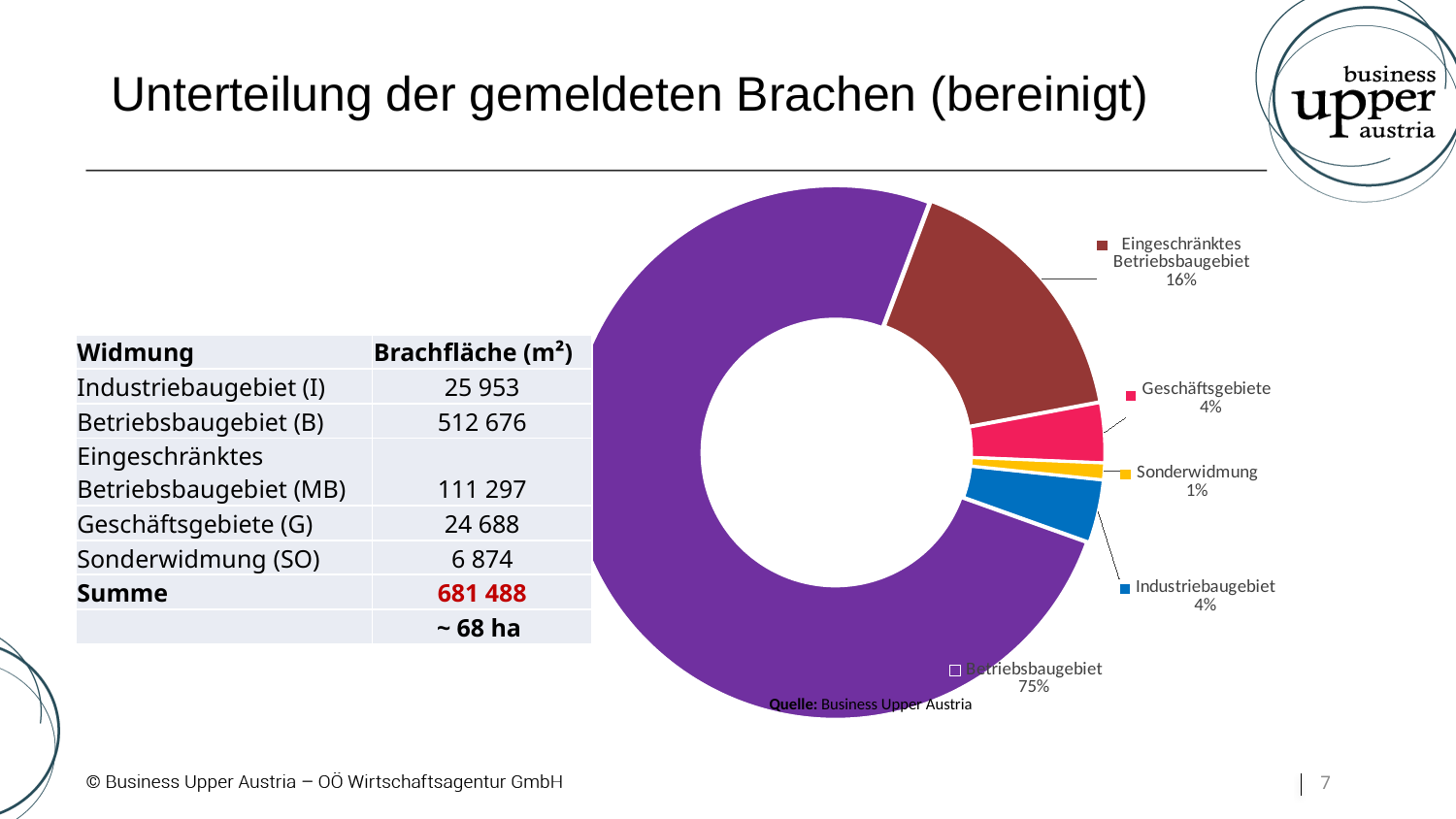
What kind of chart is shown on the slide? Doughnut (pie) chart What share of the doughnut chart does Betriebsbaugebiet represent? 75% Which category has the smallest slice in the doughnut chart? Sonderwidmung How many categories are shown in the doughnut chart? 5 Which slice is larger in the doughnut chart, Eingeschränktes Betriebsbaugebiet or Geschäftsgebiete? Eingeschränktes Betriebsbaugebiet Which category has the largest slice in the doughnut chart? Betriebsbaugebiet What share of the doughnut chart does Eingeschränktes Betriebsbaugebiet represent? 16% What is the difference in percentage points between the Betriebsbaugebiet slice and the Eingeschränktes Betriebsbaugebiet slice? 59 percentage points What source is cited below the doughnut chart? Business Upper Austria What share of the doughnut chart does Sonderwidmung represent? 1% What colour is the Betriebsbaugebiet slice in the doughnut chart? Purple